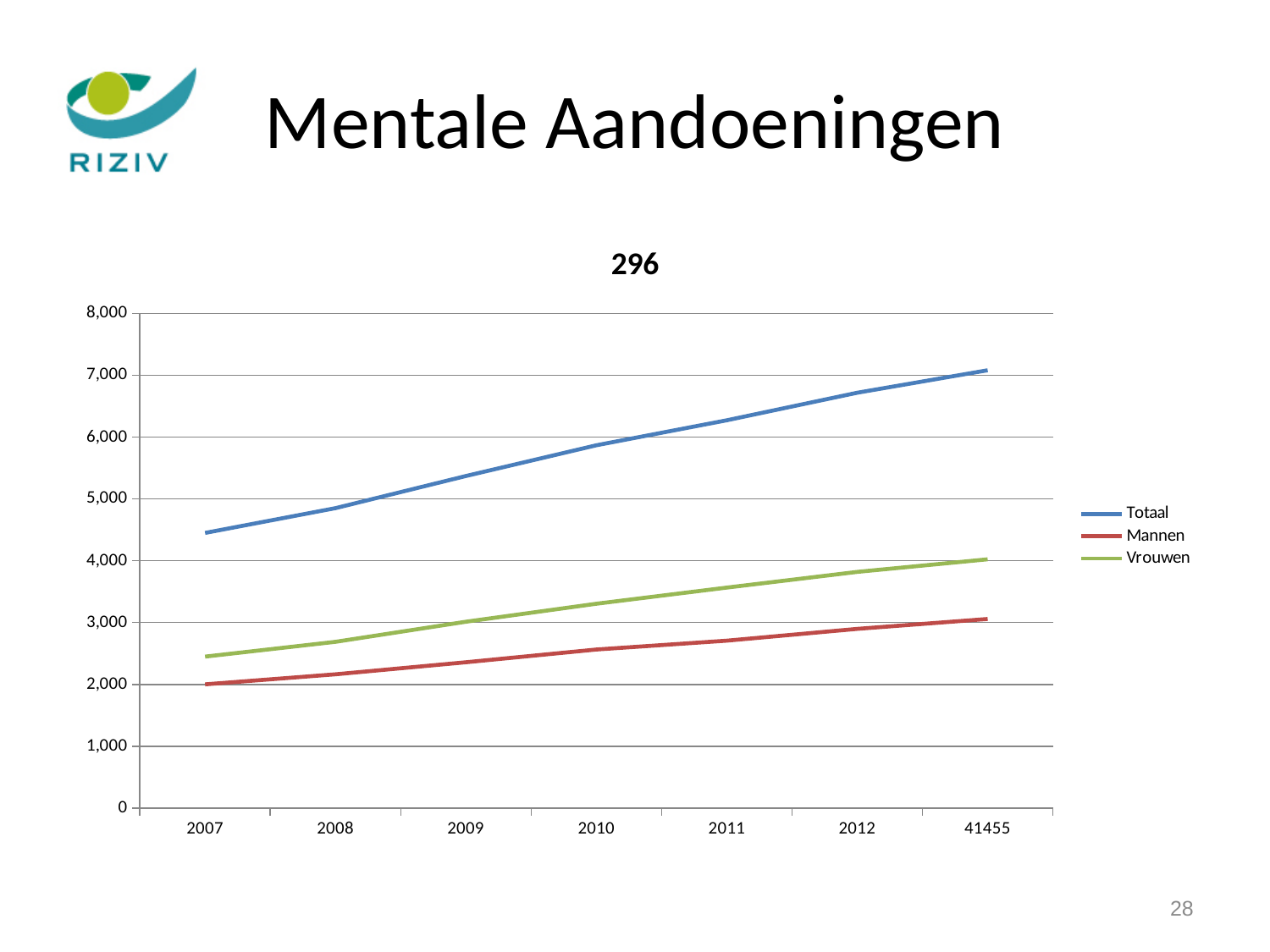
Which is larger in 2011: the value for Vrouwen or the value for Mannen? Vrouwen Which series has the lowest values throughout the chart? Mannen Is the value for Totaal in 2012 greater or less than 7,000? less Does the Totaal series rise or fall from 2007 to the last point? rise What is the title shown above the chart? 296 Which series has the highest values throughout the chart? Totaal Is the value for Totaal in 2007 greater or less than 4,000? greater What kind of chart is shown on the slide? line chart Is the value for Vrouwen in 2010 greater or less than 3,000? greater Does the Mannen series rise or fall across the x axis? rise How many points are plotted along the x axis for each series? 7 How many series does the legend list? 3